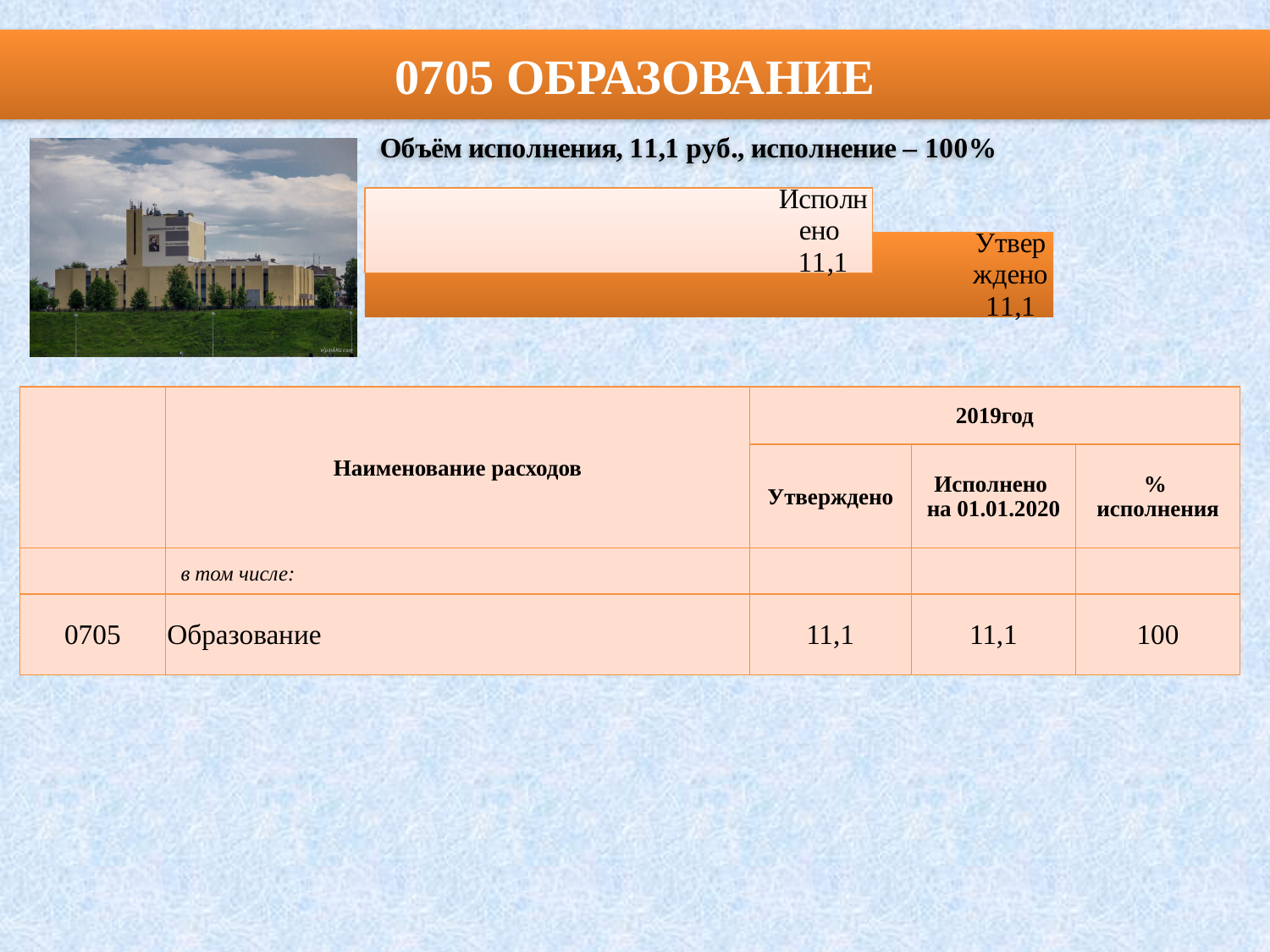
How many bars does the chart show? 2 What is the value of the "Утверждено" bar in the chart? 11,1 Which bar in the chart is coloured dark orange? Утверждено What is the value of the "Исполнено" bar in the chart? 11,1 What kind of chart is shown on the slide? bar chart What is the difference between the "Утверждено" and "Исполнено" values in the chart? 0 Are the bars in the chart horizontal or vertical? horizontal Is the value for "Утверждено" greater than, less than, or equal to the value for "Исполнено" in the chart? equal